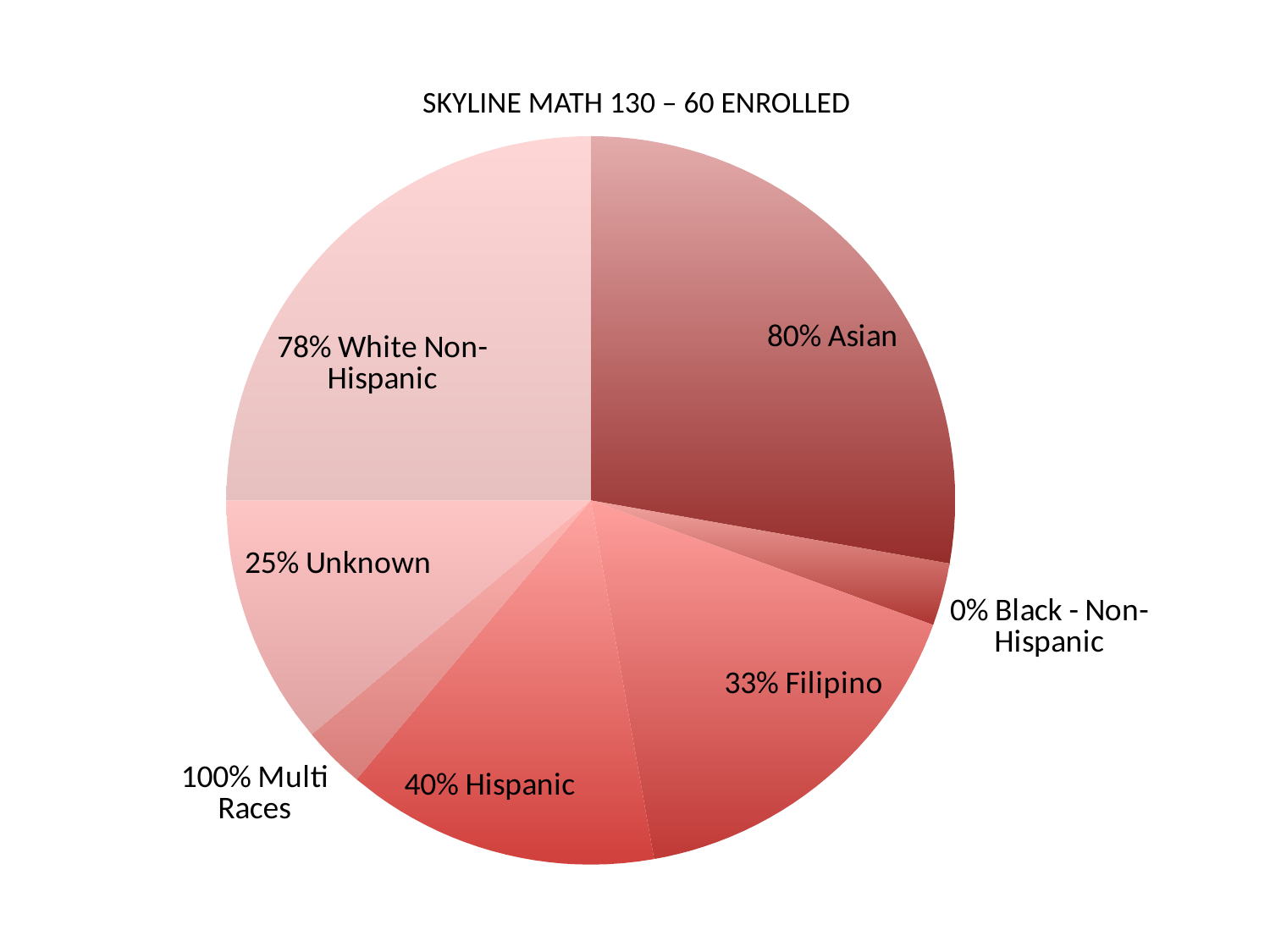
What percentage is printed in the label for Hispanic? 40% Which labelled category shows the lowest printed percentage? Black - Non-Hispanic What percentage is printed in the label for Asian? 80% What percentage is printed in the label for White Non-Hispanic? 78% What kind of chart is shown on the slide? pie chart What percentage is printed in the label for Black - Non-Hispanic? 0% What percentage is printed in the label for Filipino? 33% Which has the larger printed percentage, Hispanic or Filipino? Hispanic What is the difference between the printed percentages for Asian and Filipino? 47% What is the title of the chart? SKYLINE MATH 130 – 60 ENROLLED What percentage is printed in the label for Unknown? 25% Which labelled category shows the highest printed percentage? Multi Races